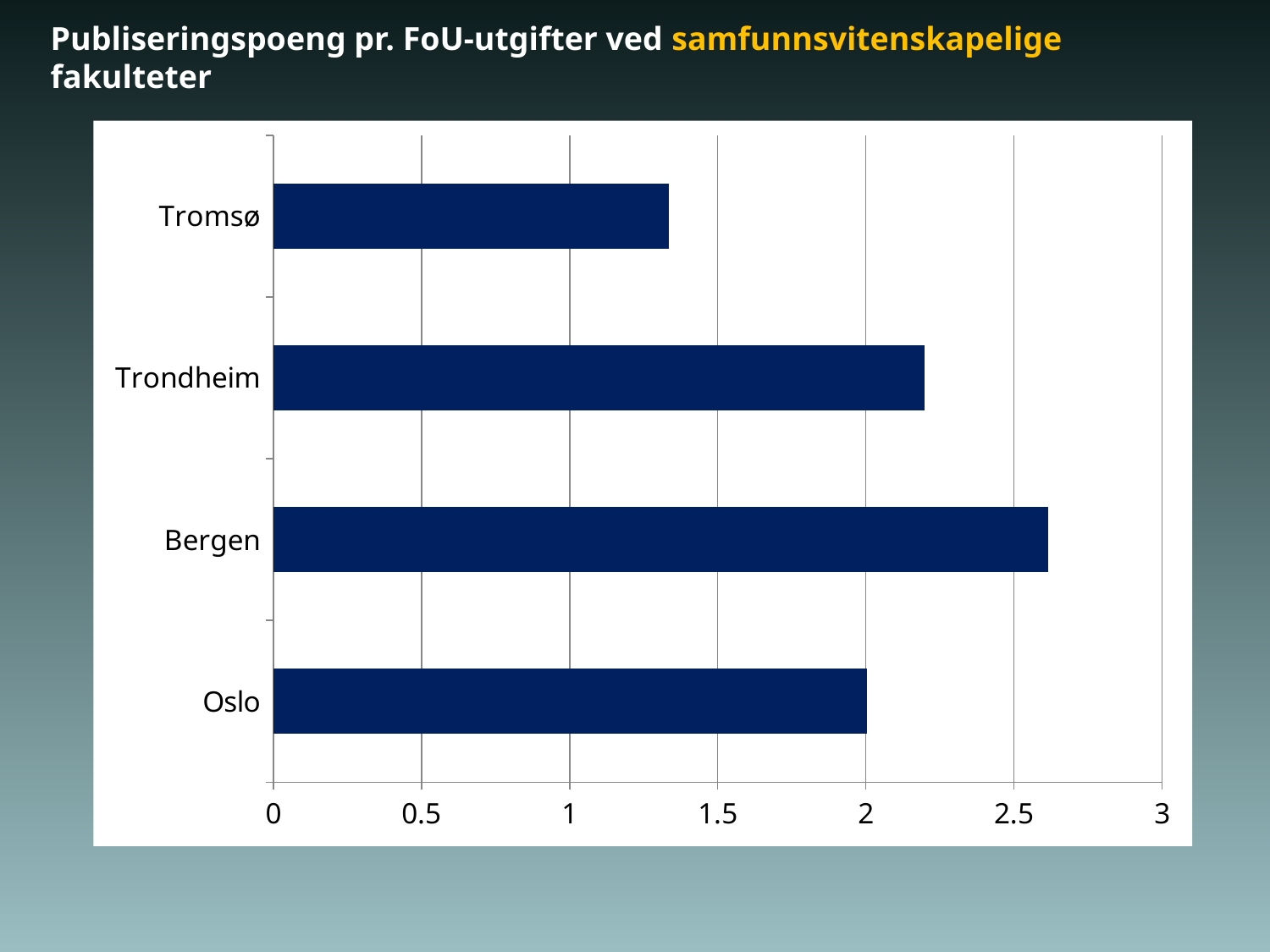
Which category has the lowest value? Tromsø Is the value for Bergen greater or less than 2.5? greater How many categories are plotted in the chart? 4 What is the title of the slide containing the chart? Publiseringspoeng pr. FoU-utgifter ved samfunnsvitenskapelige fakulteter Is the value for Tromsø greater or less than 1.5? less Is the value for Tromsø greater or less than 1? greater Which has a larger value, Tromsø or Bergen? Bergen Which has a larger value, Trondheim or Oslo? Trondheim Which category has the highest value? Bergen What is the maximum value shown on the horizontal axis? 3 What kind of chart is shown on the slide? bar chart